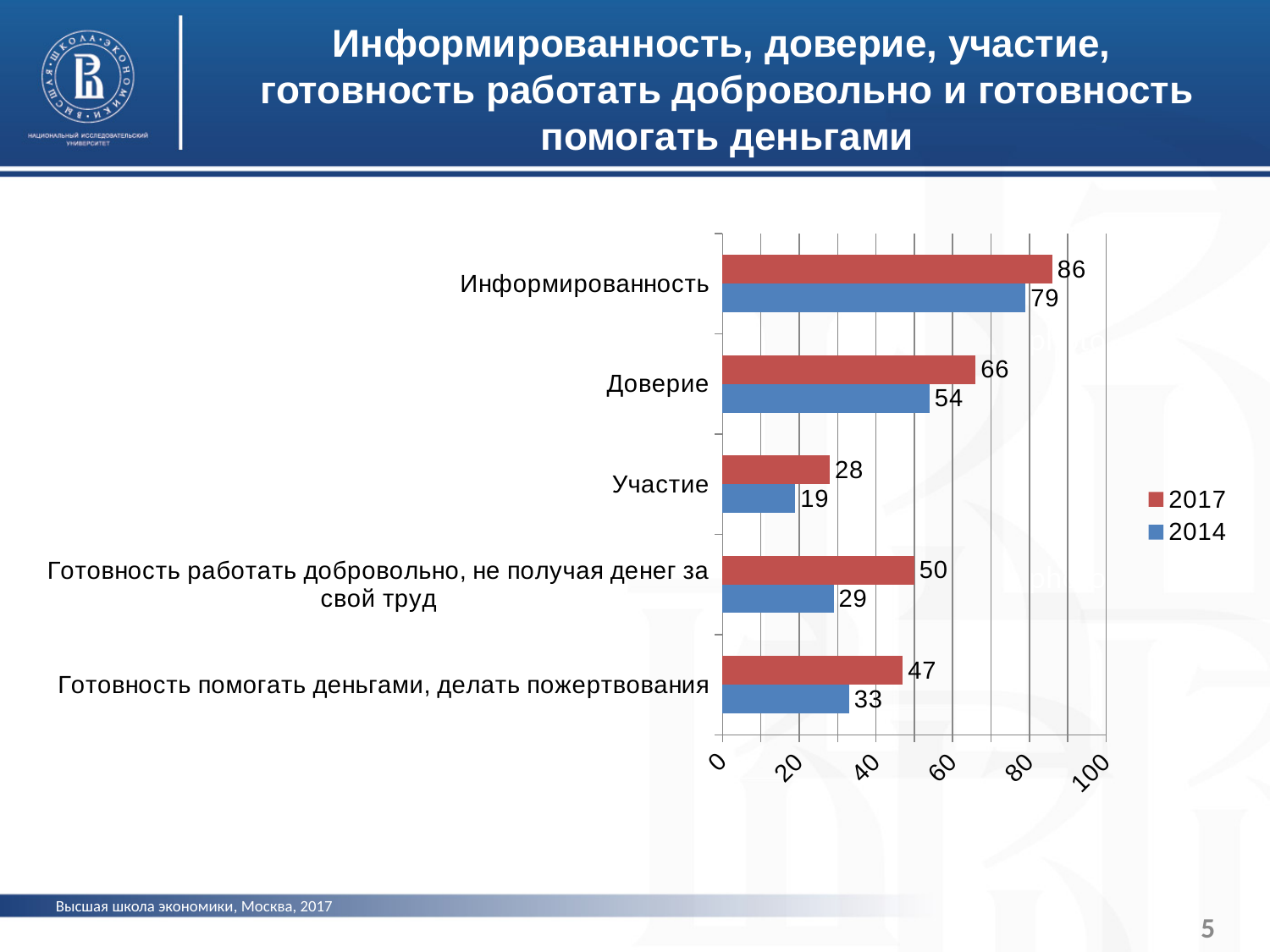
How many categories are shown on the chart? 5 What is the 2017 value for Информированность? 86 What is the difference between the 2017 and 2014 values for Готовность работать добровольно, не получая денег за свой труд? 21 Which colour represents the 2014 series? Blue Which category has the highest 2017 value? Информированность Which is larger: the 2017 value for Доверие or the 2017 value for Готовность работать добровольно, не получая денег за свой труд? Доверие What is the 2014 value for Участие? 19 Which category has the lowest 2014 value? Участие How many series does the legend list? 2 What is the 2014 value for Доверие? 54 What is the 2017 value for Готовность помогать деньгами, делать пожертвования? 47 What kind of chart is shown on the slide? Bar chart